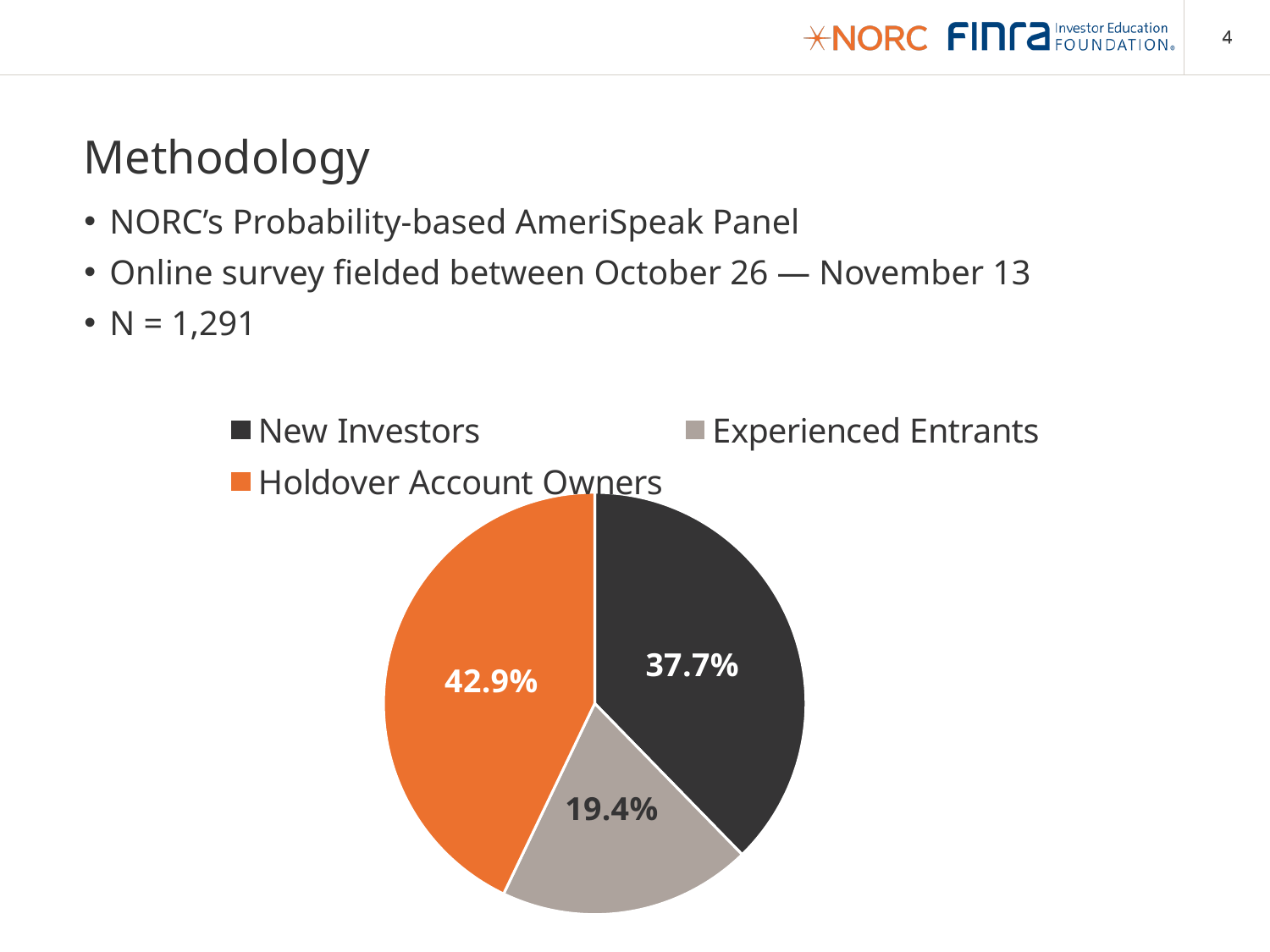
What colour is the Holdover Account Owners slice? orange Which slice is larger, New Investors or Experienced Entrants? New Investors How many slices does the pie chart have? 3 Which category has the smallest slice of the pie? Experienced Entrants Which category has the largest slice of the pie? Holdover Account Owners What is the difference in percentage points between the Holdover Account Owners slice and the New Investors slice? 5.2 What is the difference in percentage points between the New Investors slice and the Experienced Entrants slice? 18.3 What share of the pie is labelled for New Investors? 37.7% What share of the pie is labelled for Holdover Account Owners? 42.9% What kind of chart is shown on the slide? pie chart How many entries does the legend list? 3 What share of the pie is labelled for Experienced Entrants? 19.4%